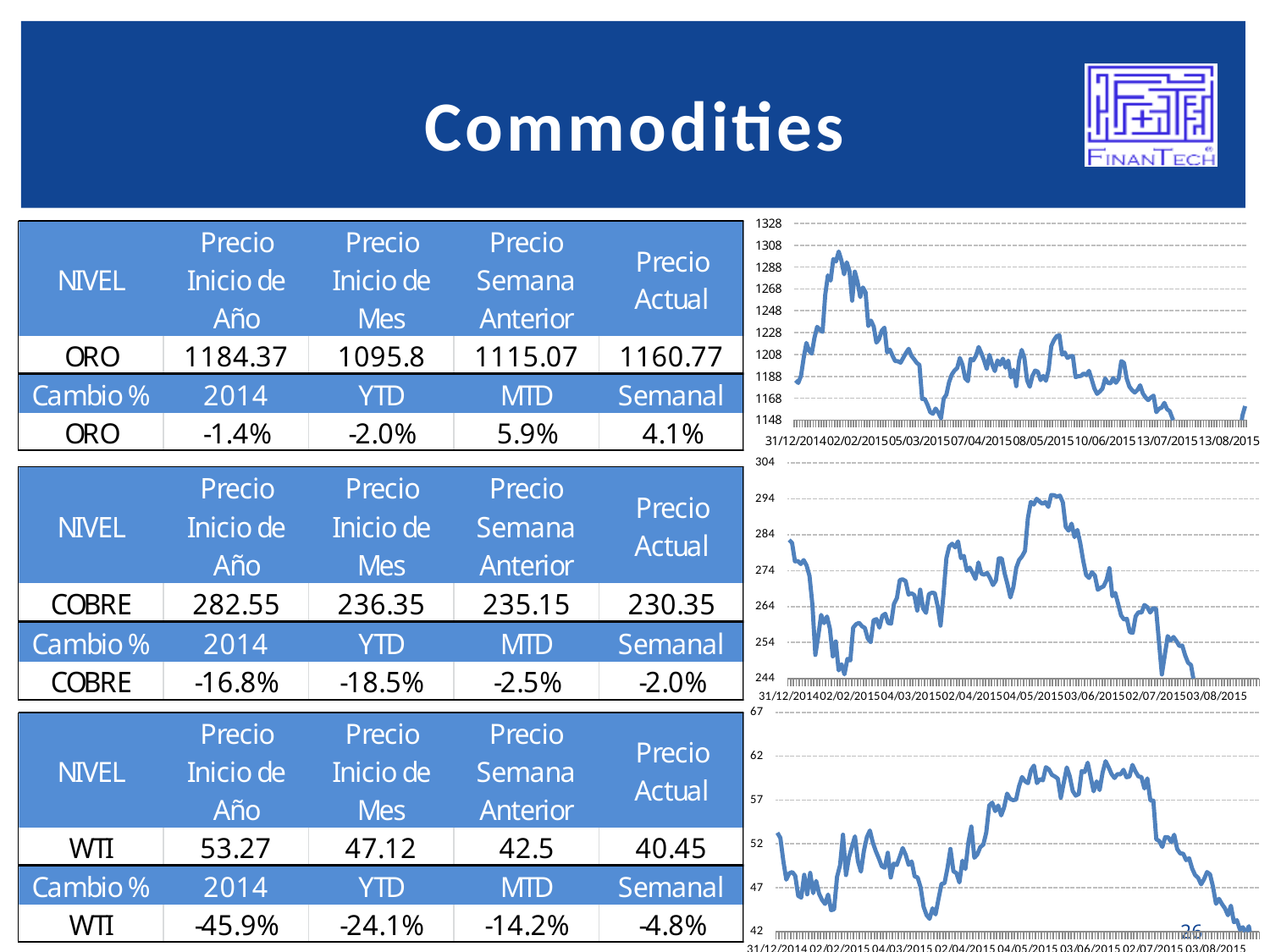
In the middle chart (y axis from 244 to 304), does the line end higher or lower than where it starts on 31/12/2014? lower In the bottom chart (y axis from 42 to 67), does the line end higher or lower than where it starts on 31/12/2014? lower In the bottom chart (y axis from 42 to 67), is the highest point of the line greater or less than 57? greater In the middle chart (y axis from 244 to 304), is the highest point of the line greater or less than 284? greater What kind of chart is the top chart on the right side of the slide? line chart In the bottom chart (y axis from 42 to 67), is the value at the right end of the line (03/08/2015) greater or less than 47? less How many charts are shown on the slide? 3 What is the first date label on the x axis of the top chart? 31/12/2014 What is the highest tick value shown on the y axis of the top chart? 1328